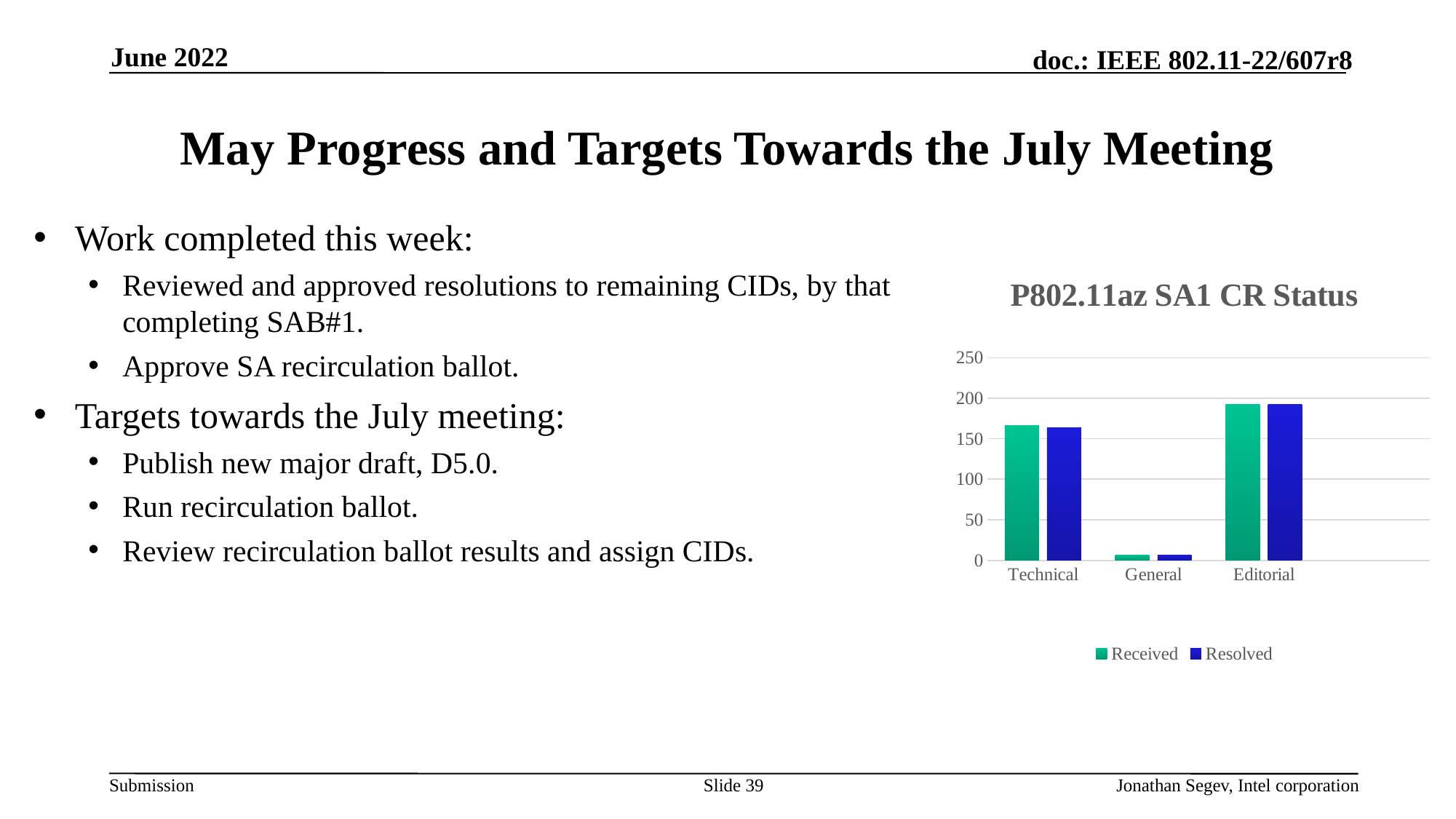
Which is larger, the Resolved value for General or the Resolved value for Technical? Technical Is the Received value for Technical greater or less than 150? greater What is the title of the chart? P802.11az SA1 CR Status What kind of chart is shown on the slide? bar chart Which category has the lowest Resolved value? General Which series are listed in the chart legend? Received and Resolved Is the Resolved value for Editorial greater or less than 200? less Which category has the highest Received value? Editorial Which is larger, the Received value for Technical or the Received value for Editorial? Editorial How many series does the chart legend list? 2 Is the Received value for General greater or less than 50? less How many categories are shown on the x axis of the chart? 3